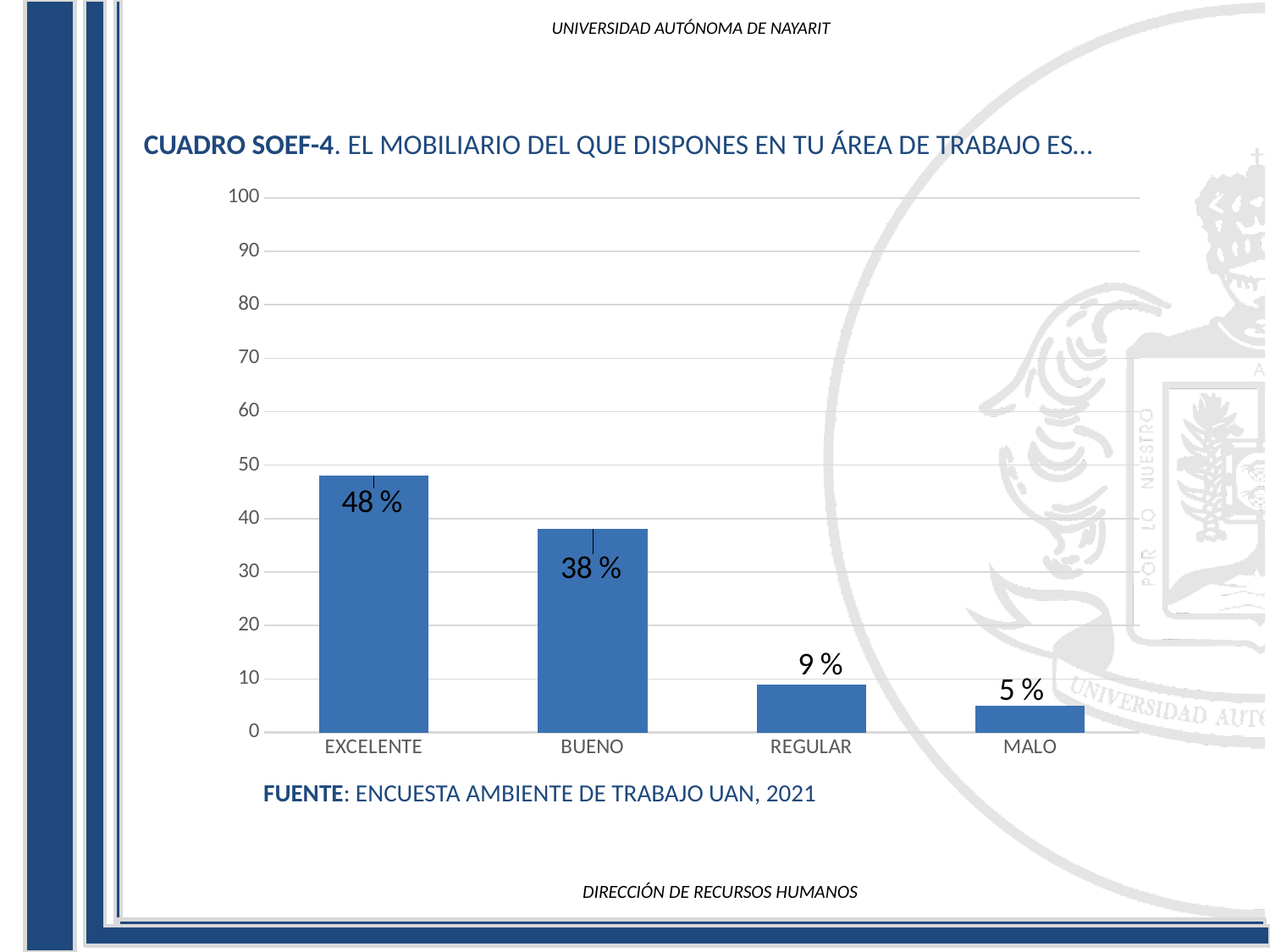
What is the value for MALO? 5 % What is the value for EXCELENTE? 48 % What is the difference between the values for EXCELENTE and BUENO? 10 % How many categories are shown on the x axis? 4 What is the value for REGULAR? 9 % Which is larger, the value for REGULAR or the value for MALO? REGULAR Which category has the lowest value? MALO What kind of chart is shown on the slide? bar chart What is the value for BUENO? 38 % Is the value for BUENO greater or less than 40? less Do the values rise or fall from left to right along the x axis? fall Which category has the highest value? EXCELENTE